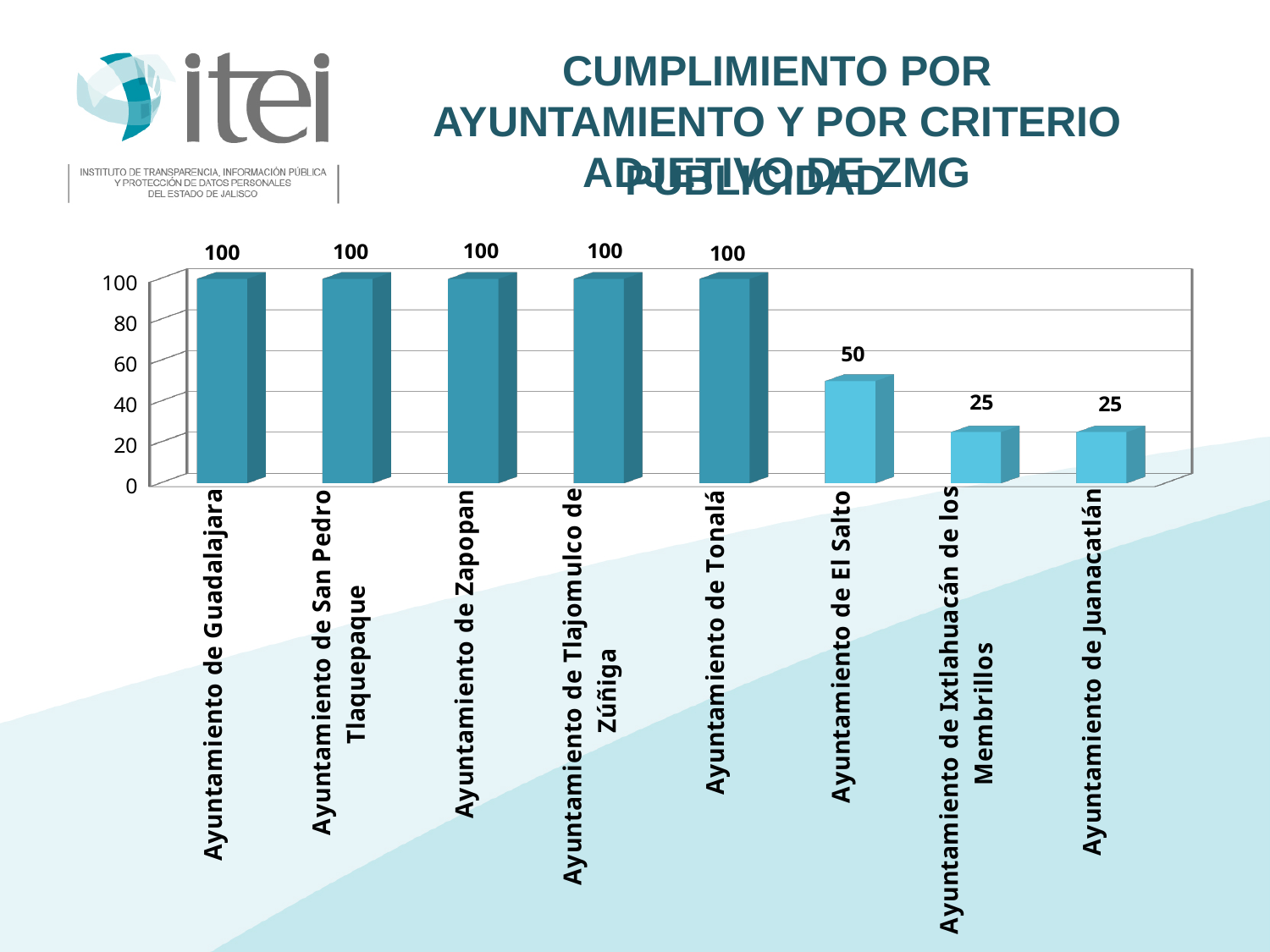
Is the value for Ayuntamiento de El Salto greater or less than 40? greater What is the difference between the values for Ayuntamiento de Zapopan and Ayuntamiento de El Salto? 50 What kind of chart is shown on the slide? bar chart How many ayuntamientos have a value of 100? 5 Which is larger, the value for Ayuntamiento de El Salto or the value for Ayuntamiento de Ixtlahuacán de los Membrillos? Ayuntamiento de El Salto What is the difference between the values for Ayuntamiento de El Salto and Ayuntamiento de Juanacatlán? 25 What is the value for Ayuntamiento de Juanacatlán? 25 What is the value for Ayuntamiento de Ixtlahuacán de los Membrillos? 25 How many ayuntamientos (categories) are shown in the chart? 8 What is the value for Ayuntamiento de Guadalajara? 100 What is the value for Ayuntamiento de El Salto? 50 What is the value for Ayuntamiento de Tonalá? 100